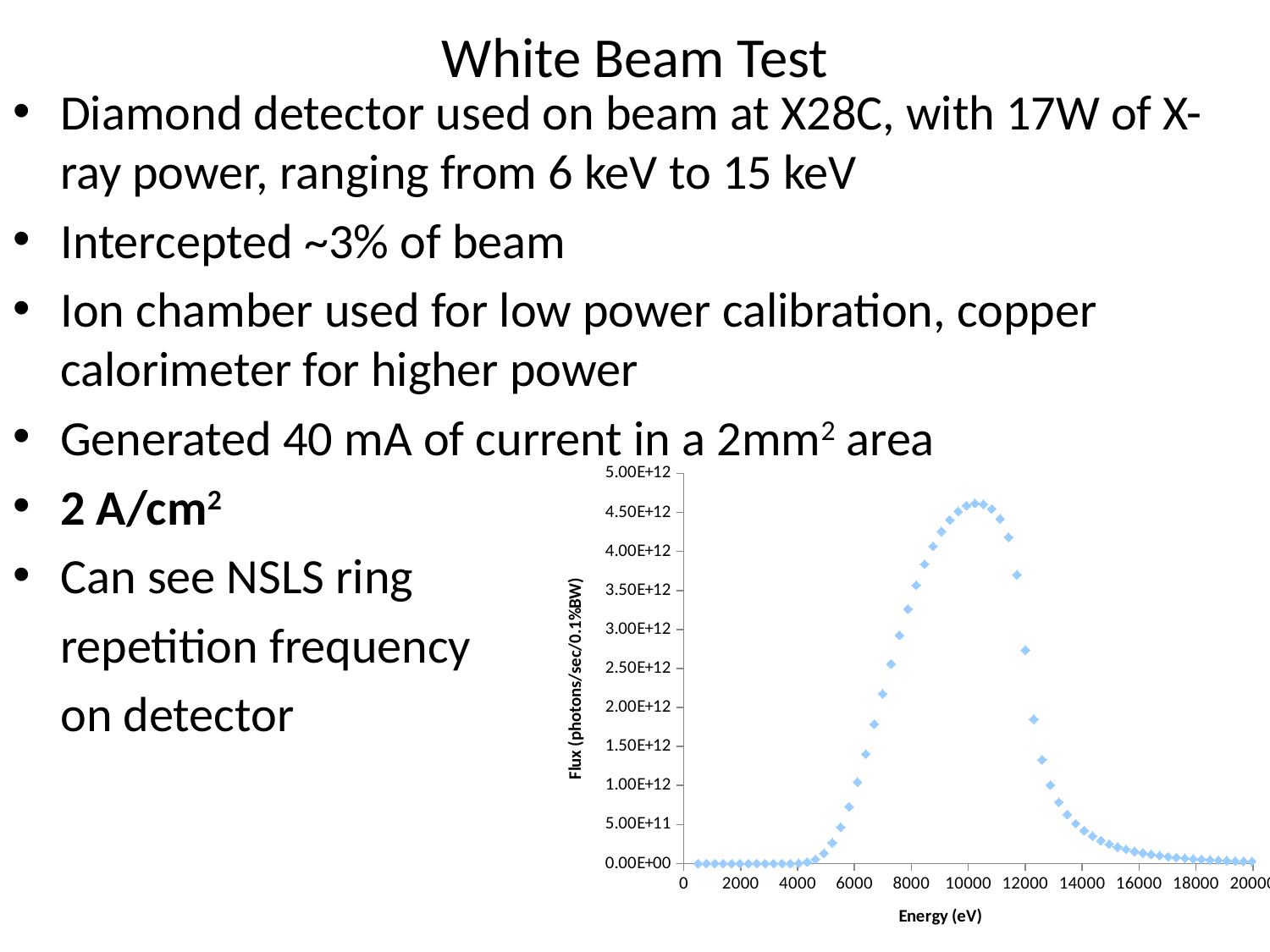
Does the flux rise or fall as energy increases from 12000 eV to 20000 eV? fall Is the flux at 12000 eV greater or less than 3.00E+12? less Is the flux at 16000 eV greater or less than 5.00E+11? less Is the flux at 18000 eV greater or less than 1.00E+12? less Which is larger, the flux at 10000 eV or the flux at 14000 eV? 10000 eV Does the flux rise or fall as energy increases from 4000 eV to 10000 eV? rise What is the title of the y axis of the chart? Flux (photons/sec/0.1%BW) What is the title of the x axis of the chart? Energy (eV) What kind of chart is shown on the slide? scatter chart